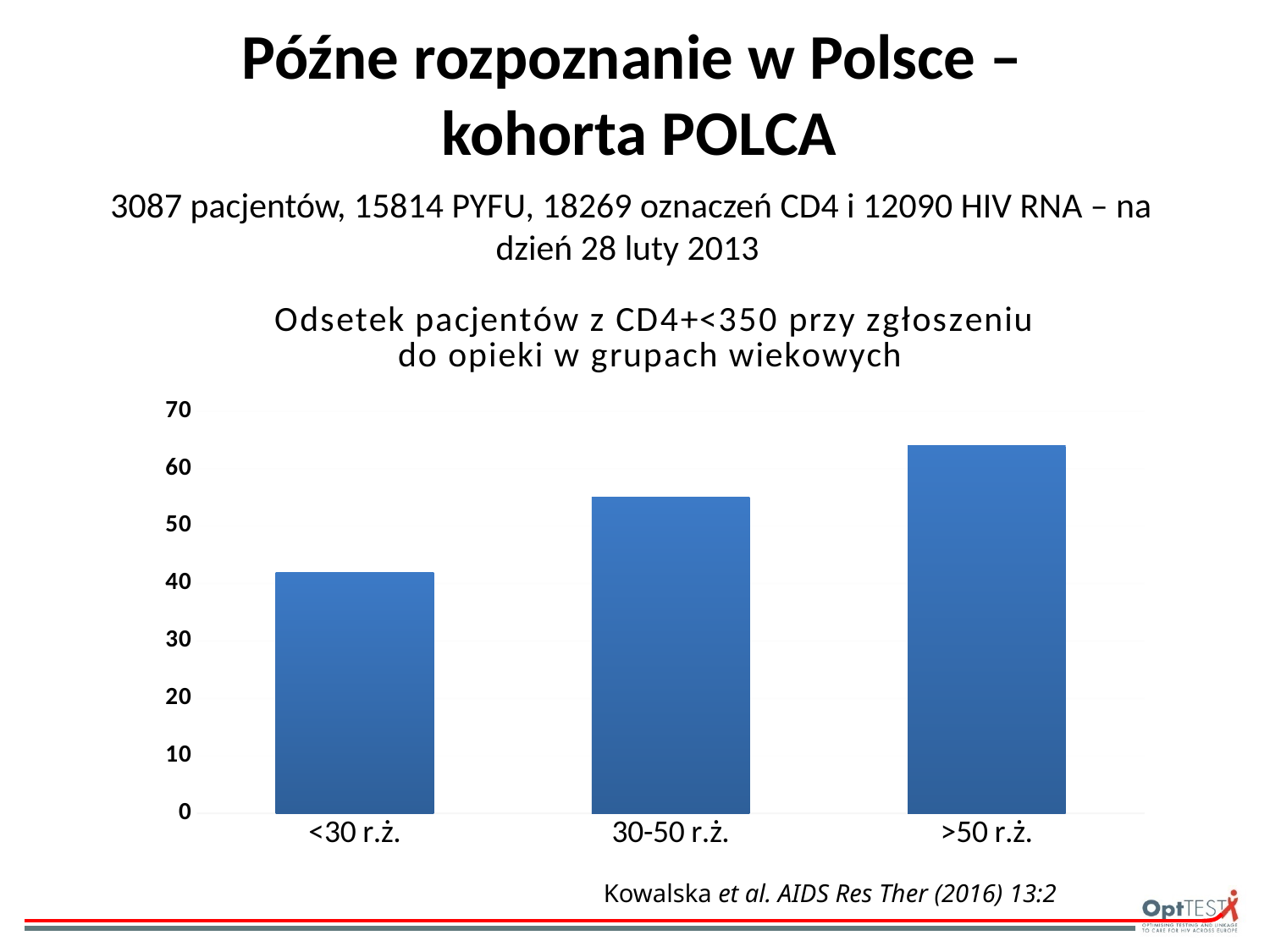
What kind of chart is shown on the slide? bar chart Which has a larger value, the 30-50 r.ż. group or the <30 r.ż. group? 30-50 r.ż. Which age group has the lowest percentage of patients with CD4+<350 at entry to care? <30 r.ż. Which has a larger value, the >50 r.ż. group or the 30-50 r.ż. group? >50 r.ż. Is the value for >50 r.ż. greater or less than 60? greater Do the values rise or fall from the youngest to the oldest age group along the x axis? rise Is the value for 30-50 r.ż. greater or less than 50? greater Is the value for <30 r.ż. greater or less than 50? less Which age group has the highest percentage of patients with CD4+<350 at entry to care? >50 r.ż. How many age groups are shown on the x axis of the chart? 3 What is the title of the chart? Odsetek pacjentów z CD4+<350 przy zgłoszeniu do opieki w grupach wiekowych